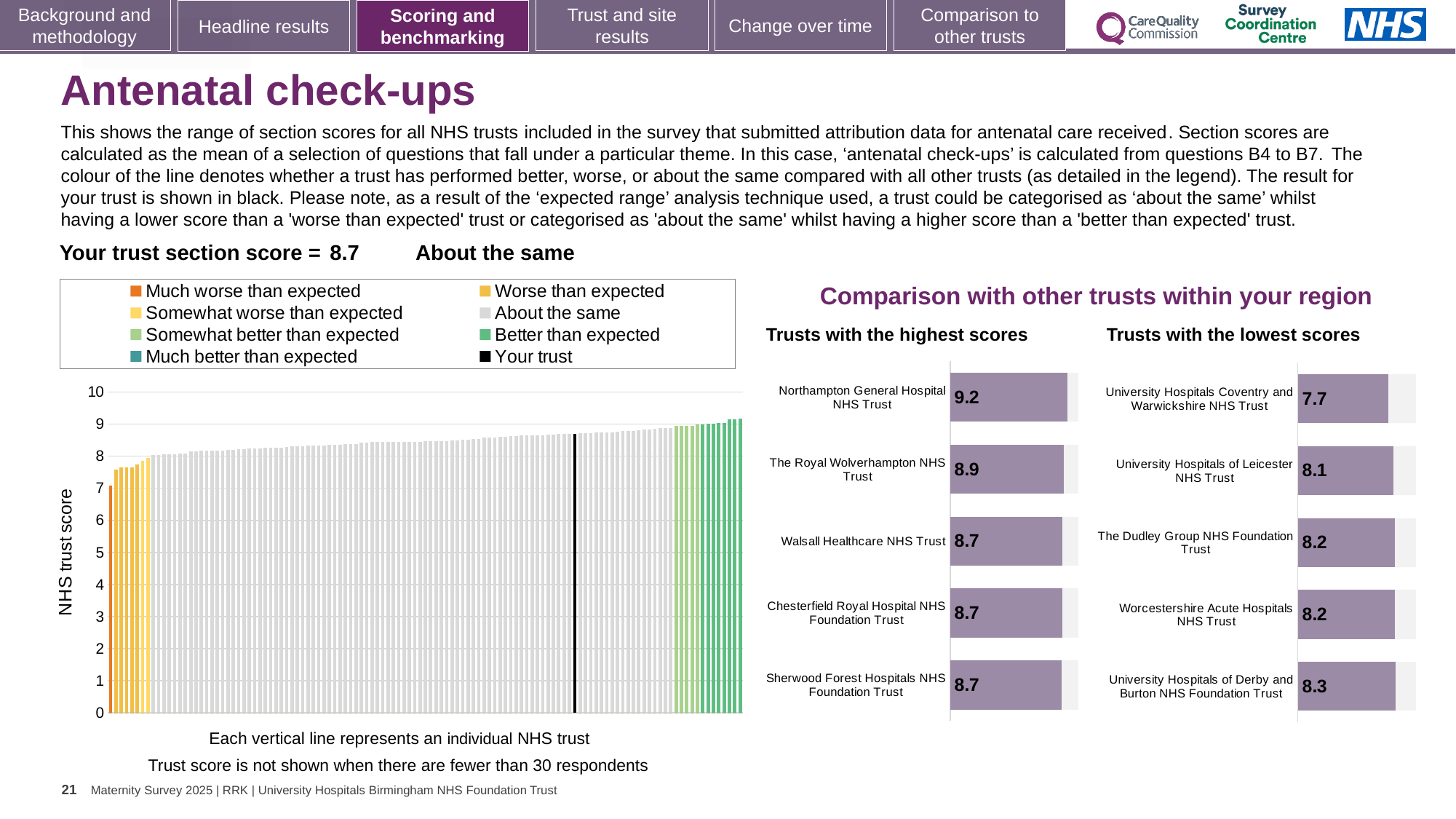
How many trusts are shown in the 'Trusts with the highest scores' chart? 5 In the 'Trusts with the highest scores' chart, what is the score for Northampton General Hospital NHS Trust? 9.2 In the 'Trusts with the highest scores' chart, which trust has the highest score? Northampton General Hospital NHS Trust In the 'Trusts with the lowest scores' chart, which has the larger score: University Hospitals of Leicester NHS Trust or The Dudley Group NHS Foundation Trust? The Dudley Group NHS Foundation Trust In the 'Trusts with the lowest scores' chart, what is the score for University Hospitals Coventry and Warwickshire NHS Trust? 7.7 What is the difference between the score for Northampton General Hospital NHS Trust in the highest scores chart and the score for University Hospitals Coventry and Warwickshire NHS Trust in the lowest scores chart? 1.5 In the 'Trusts with the lowest scores' chart, which trust has the lowest score? University Hospitals Coventry and Warwickshire NHS Trust How many entries does the legend of the main NHS trust score chart list? 8 In the 'Trusts with the highest scores' chart, what is the score for The Royal Wolverhampton NHS Trust? 8.9 In the main NHS trust score chart on the left, is the value for the black 'Your trust' bar greater or less than 8? greater In the 'Trusts with the lowest scores' chart, what is the score for University Hospitals of Derby and Burton NHS Foundation Trust? 8.3 What kind of chart is the 'Trusts with the lowest scores' chart? Bar chart